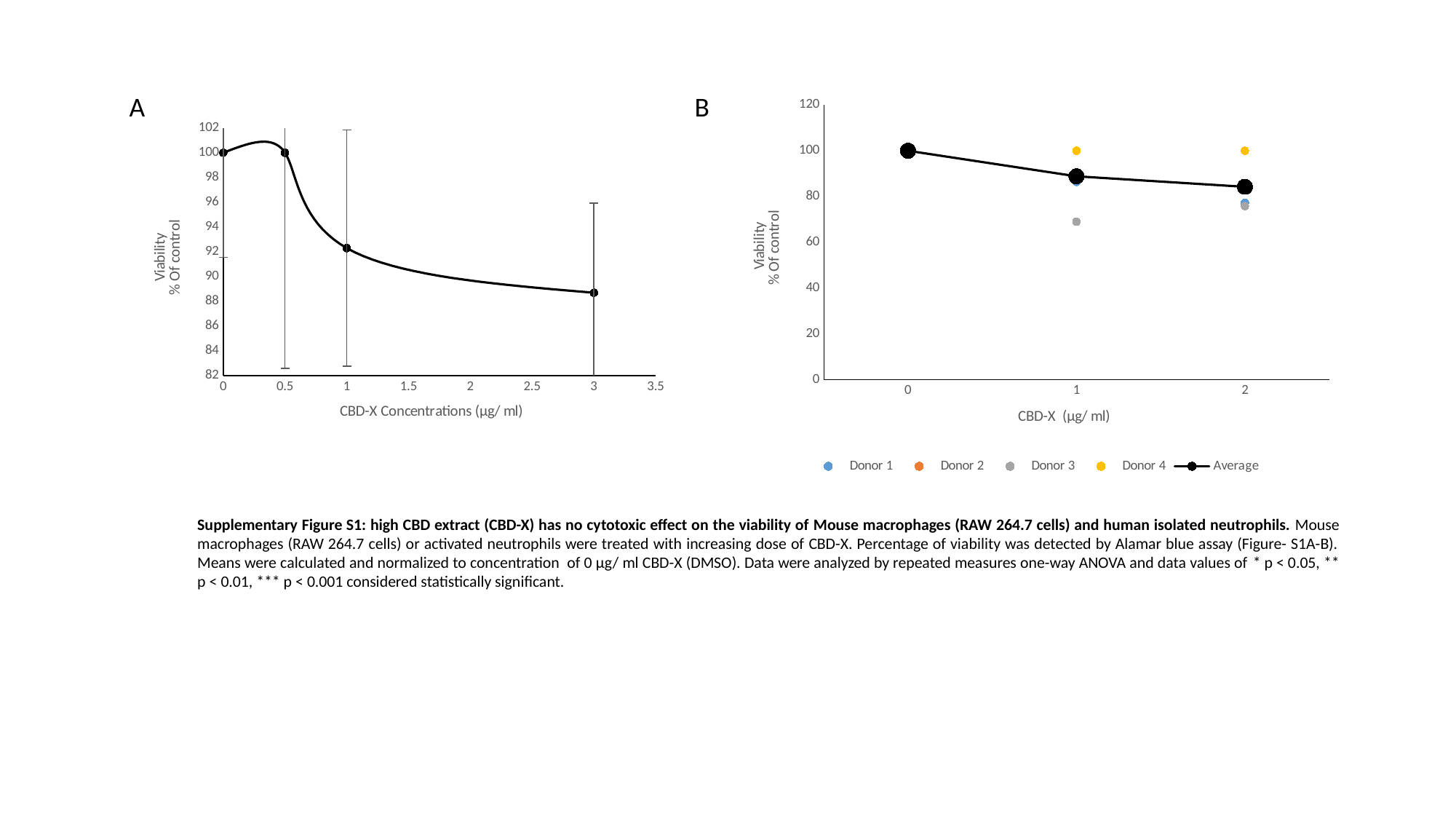
In chart B, which is larger at 1 µg/ml: the Donor 4 value or the Donor 3 value? Donor 4 In chart A, what is the x-axis title? CBD-X Concentrations (µg/ ml) What kind of chart is chart A on the left? line chart In chart B, how many series does the legend list? 5 In chart B, does the Average line rise or fall as CBD-X concentration increases? fall In chart B, how many CBD-X concentrations are shown on the x axis? 3 In chart A, how many data points are plotted on the line? 4 In chart A, at which CBD-X concentration is viability lowest? 3 In chart B, is the Average value at 2 µg/ml greater or less than 80? greater In chart A, is the viability value at 3 µg/ml greater or less than 90? less In chart A, is the viability value at 1 µg/ml greater or less than 90? greater In chart A, does viability rise or fall as CBD-X concentration increases from 0.5 to 3 µg/ml? fall